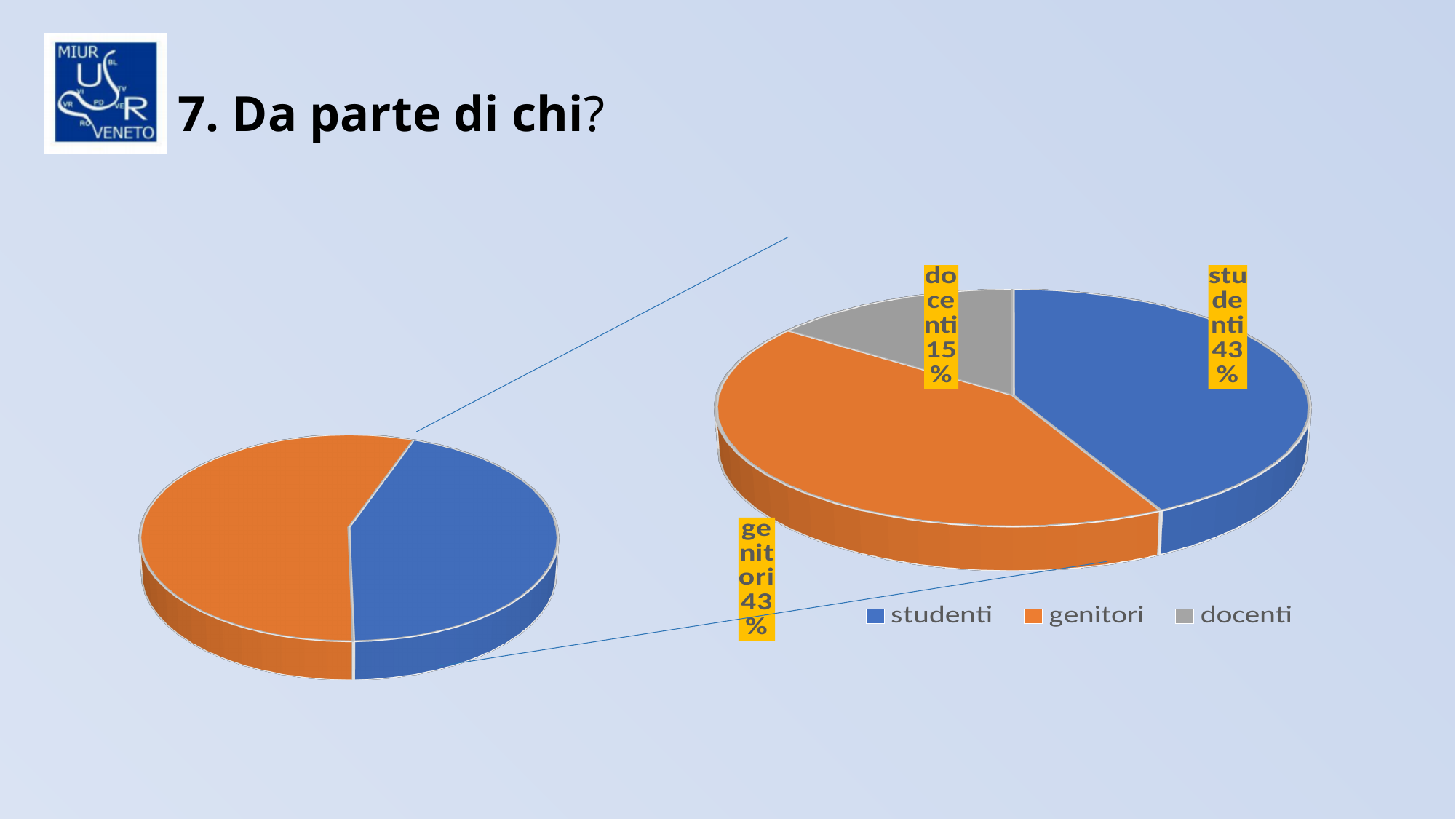
What kind of chart is the smaller chart on the left? pie chart On the larger pie chart on the right, how many slices are there? 3 What kind of chart is the larger chart on the right? pie chart On the larger pie chart on the right, what is the difference in percentage points between studenti and docenti? 28 On the larger pie chart on the right, what percentage is shown for docenti? 15% On the larger pie chart on the right, what percentage is shown for studenti? 43% On the larger pie chart on the right, which category has the smallest share? docenti On the larger pie chart on the right, which is larger, the share for genitori or the share for docenti? genitori On the larger pie chart on the right, what percentage is shown for genitori? 43% How many entries does the legend on the right-hand chart list? 3 How many slices does the smaller pie chart on the left have? 2 On the right-hand chart, which colour represents docenti in the legend? grey